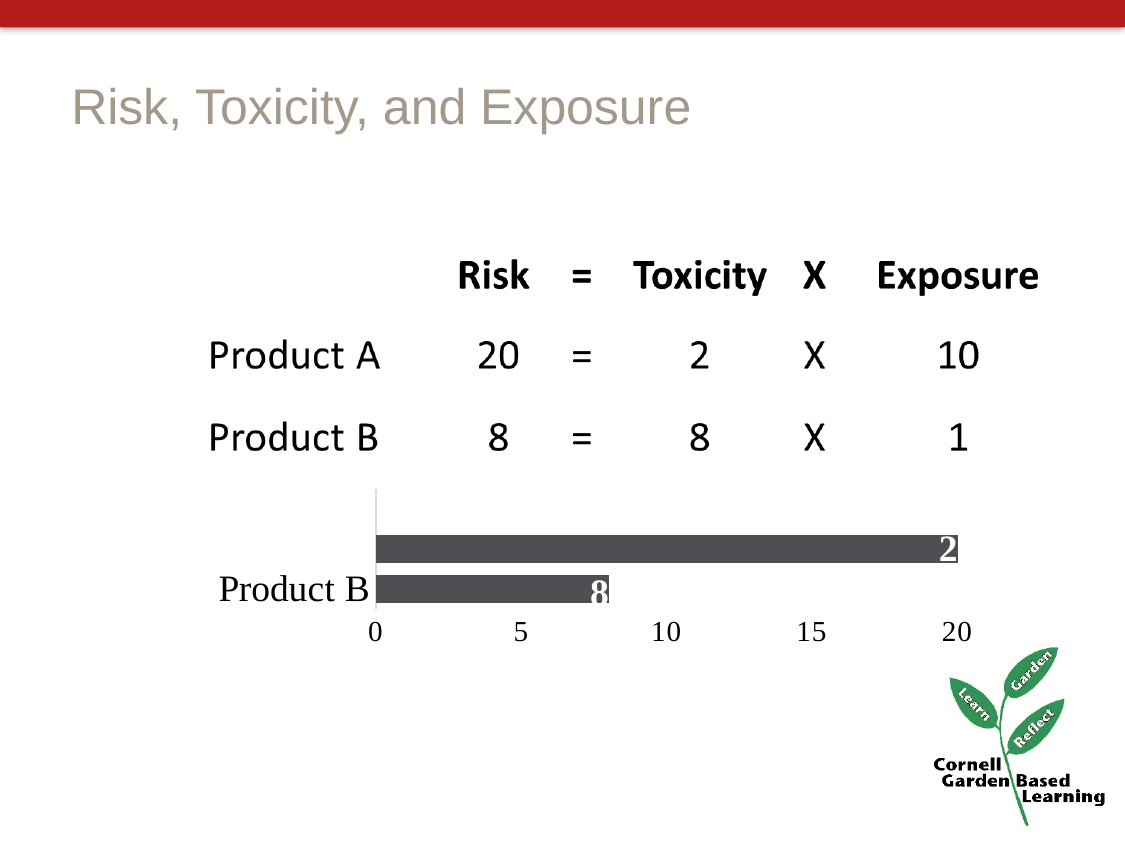
What is the value shown for Product B in the bar chart? 8 Which bar is longer, the top bar or the Product B bar? the top bar What colour are the bars in the chart? dark grey How many bars are plotted in the chart? 2 Is the value for Product B greater or less than 10? less What kind of chart is shown on the slide? bar chart Is the value for Product B greater or less than 5? greater Which bar in the chart is the shortest? Product B What is the highest tick value shown on the chart's horizontal axis? 20